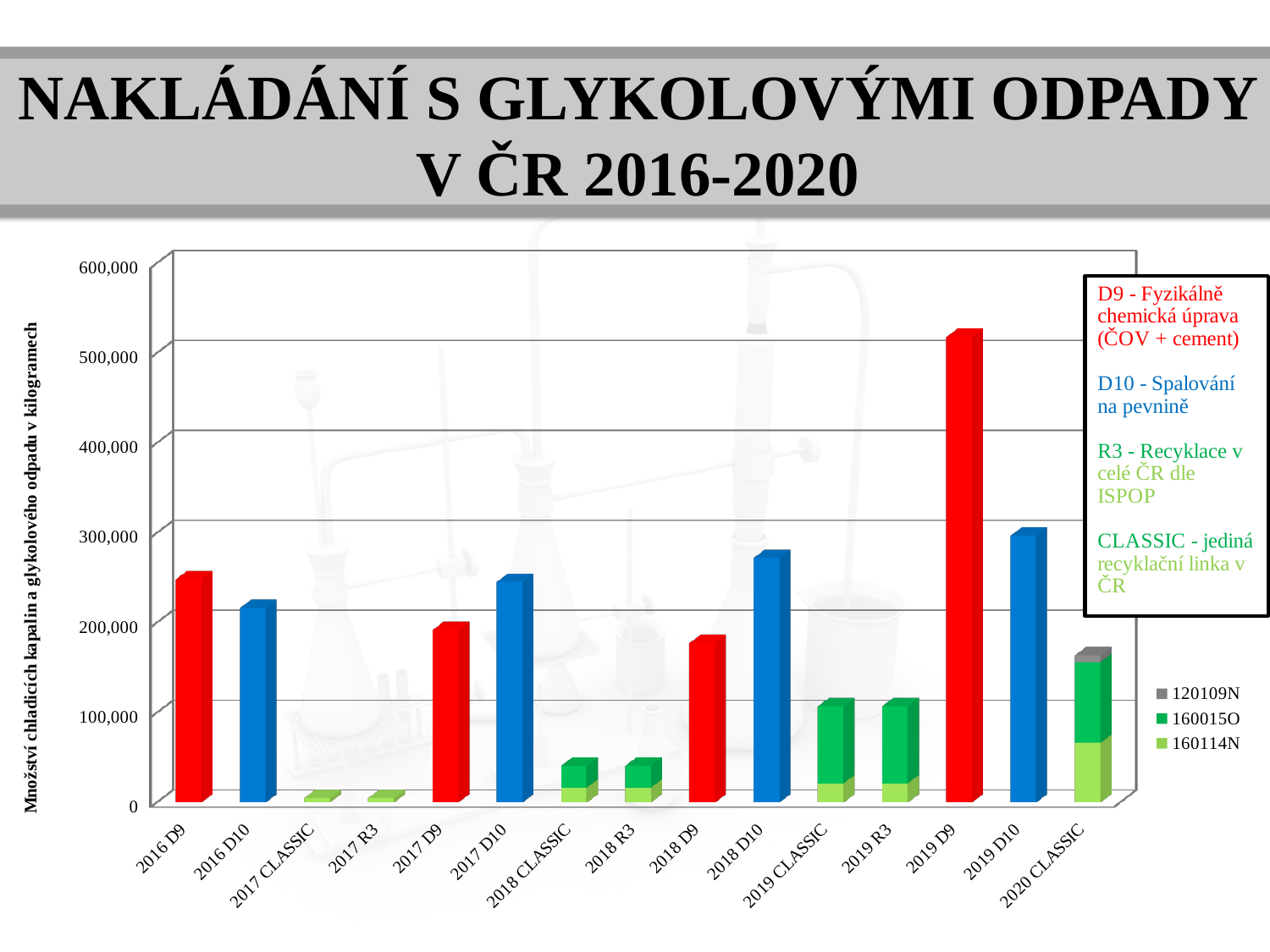
Is the value for 2019 D9 greater or less than 500,000? greater Is the total value for 2020 CLASSIC greater or less than 200,000? less What kind of chart is shown on the slide? bar chart How many series does the chart legend list? 3 Is the value for 2016 D9 greater or less than 200,000? greater What is the label of the vertical axis of the chart? Množství chladicích kapalin a glykolového odpadu v kilogramech Which category has the highest bar in the chart? 2019 D9 Which is larger, the value for 2019 D9 or the value for 2019 D10? 2019 D9 Which is larger, the value for 2018 D10 or the value for 2018 D9? 2018 D10 How many categories are shown along the x axis of the chart? 15